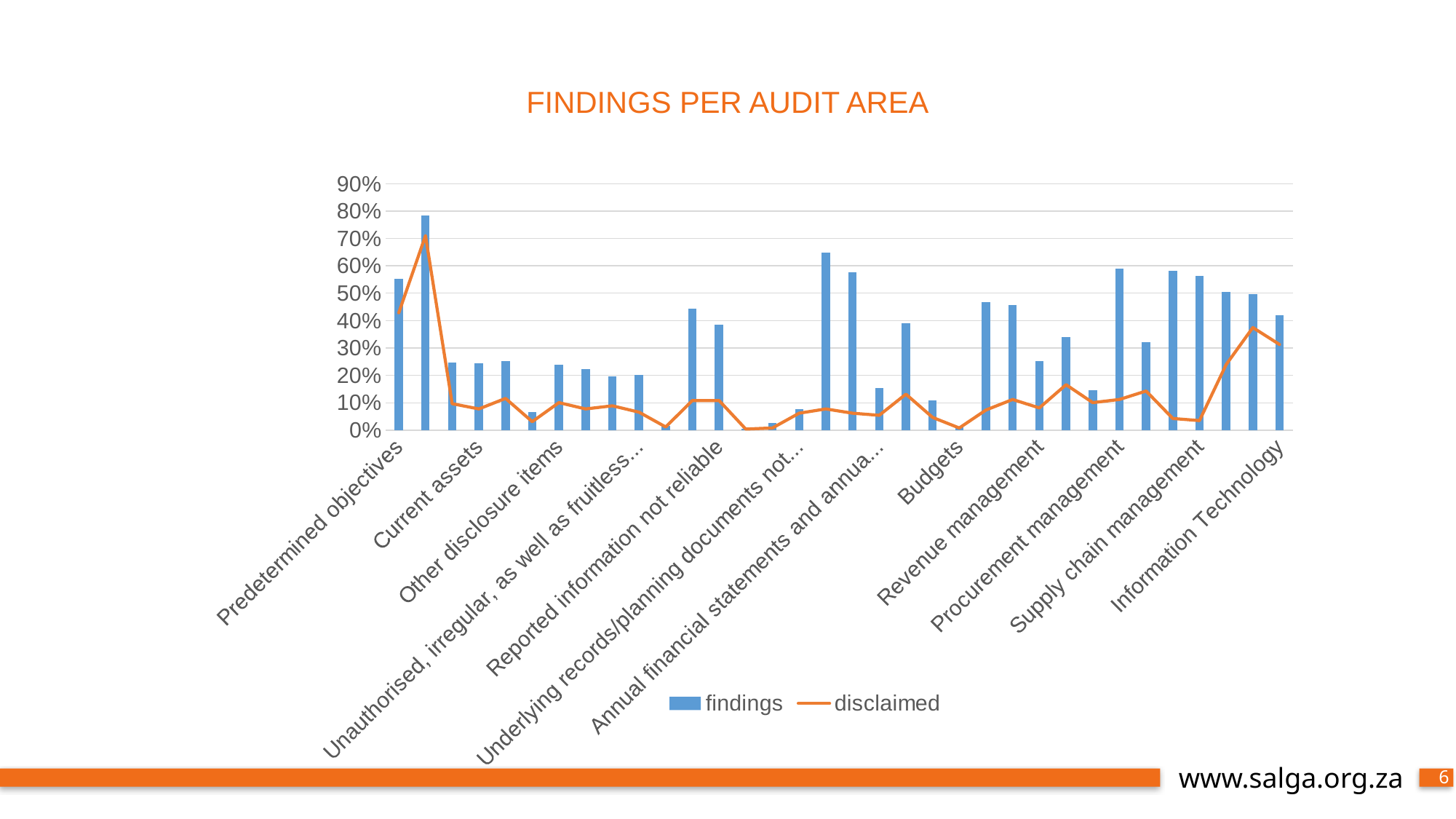
Is the disclaimed value for Information Technology greater or less than 20%? greater How many series does the legend list? 2 Is the findings value for Supply chain management greater or less than 50%? greater Which has the larger findings value, Supply chain management or Current assets? Supply chain management Is the disclaimed value for Budgets greater or less than 10%? less Which series is drawn as a line rather than bars? disclaimed Which has the larger findings value, Predetermined objectives or Budgets? Predetermined objectives For Information Technology, which series has the larger value, findings or disclaimed? findings What is the title of the chart? FINDINGS PER AUDIT AREA